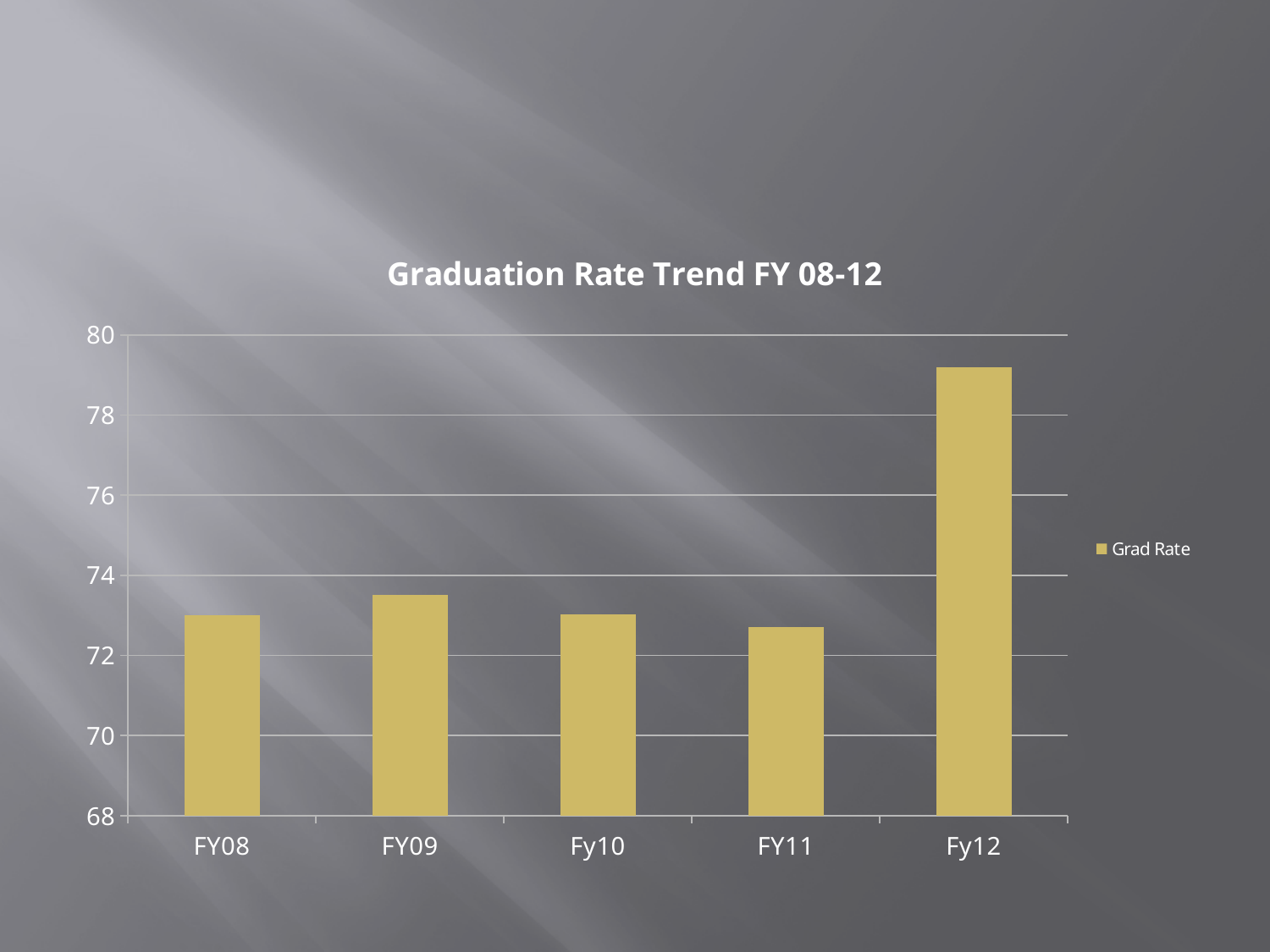
What kind of chart is shown on the slide? Bar chart Which has the larger Grad Rate, FY09 or FY11? FY09 Which fiscal year has the lowest Grad Rate? FY11 How many fiscal years are plotted on the x axis? 5 What is the title of the chart? Graduation Rate Trend FY 08-12 Is the Grad Rate for FY09 greater or less than 74? less What is the name of the series shown in the legend? Grad Rate How many series does the legend list? 1 Is the Grad Rate for Fy12 greater or less than 78? greater Is the Grad Rate for FY08 greater or less than 72? greater Which fiscal year has the highest Grad Rate? Fy12 Does the Grad Rate rise or fall from FY11 to Fy12? rise